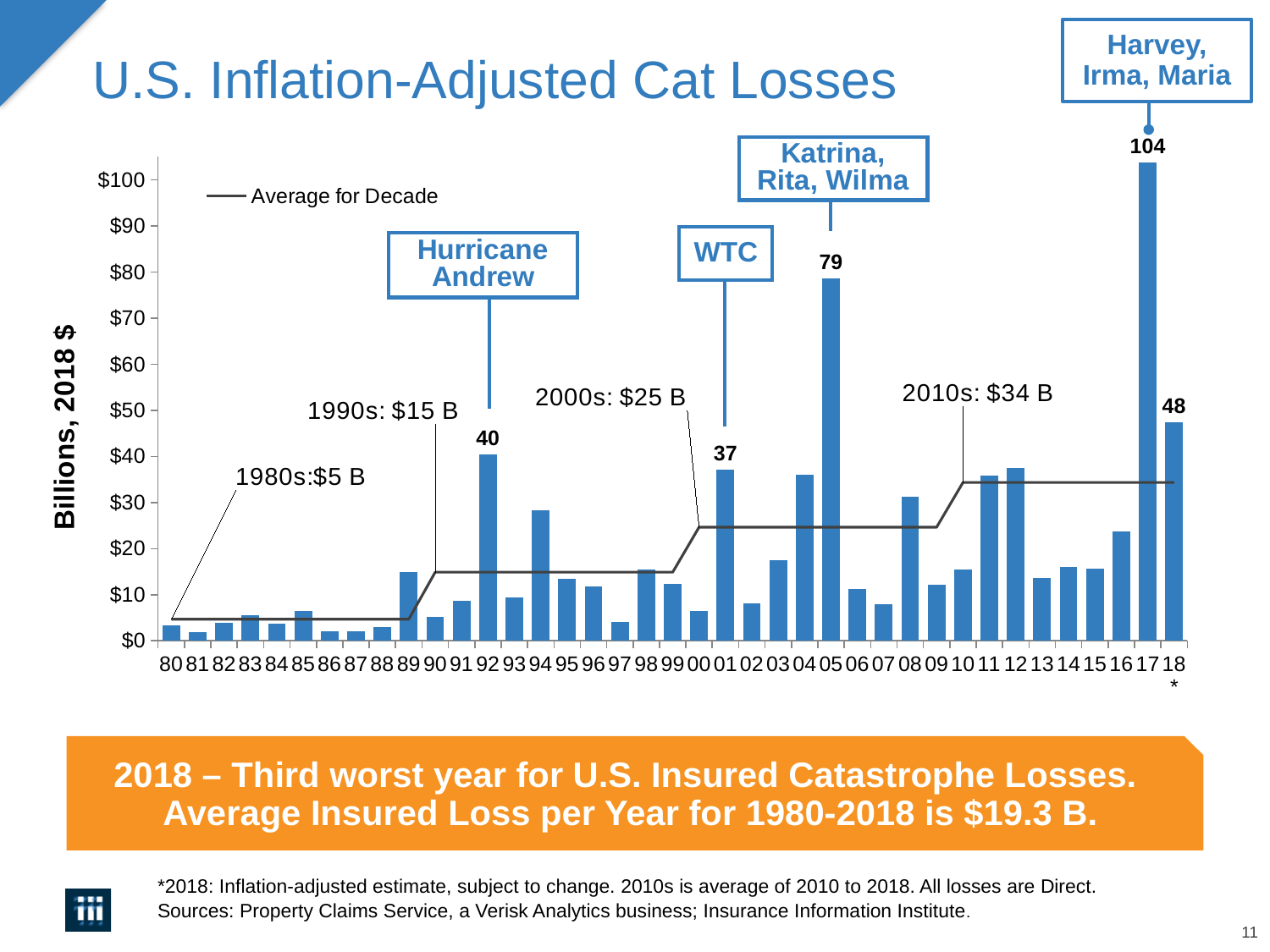
What is the value for 1992? 40 What is the average for the 2010s decade shown on the chart? $34 B What is the difference between the values for 2017 and 2018? 56 What kind of chart is shown? Combination bar and line chart Which year has the highest cat losses? 2017 Is the value for 2004 greater or less than $30? greater What is the difference between the values for 2017 and 2005? 25 What is the value for 2018? 48 What is the value for 2005? 79 Is the value for 1997 greater or less than $10? less What is the value for 2017? 104 Which is larger, the value for 1992 or the value for 2001? 1992